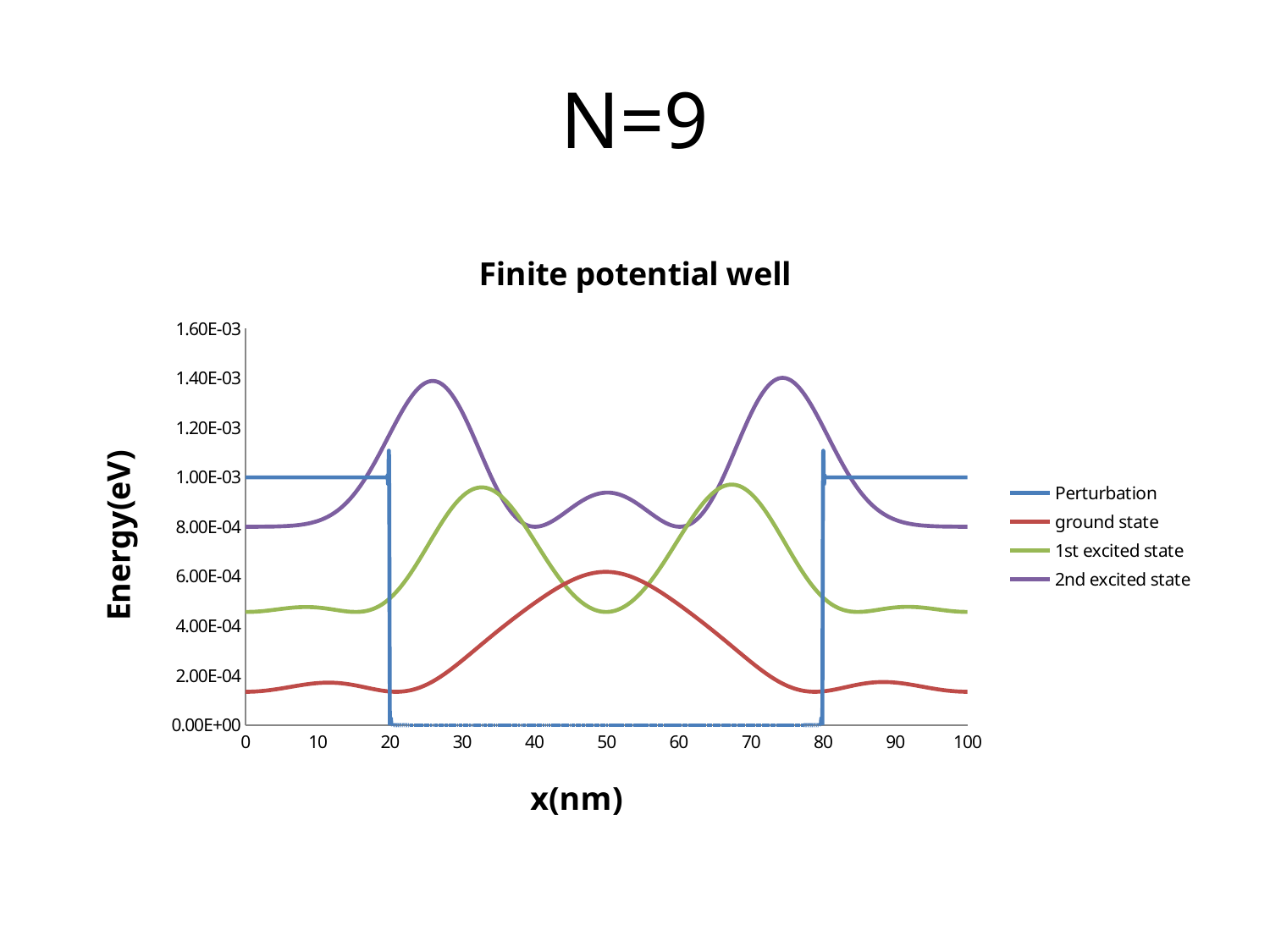
Is the peak value of the 2nd excited state near x = 25 greater or less than 1.20E-03? greater What kind of chart is shown on the slide? line chart Is the value of the 1st excited state at x = 50 greater or less than 6.00E-04? less Which series reaches the highest value anywhere on the chart? 2nd excited state Is the value of the 2nd excited state at x = 50 greater or less than 8.00E-04? greater What is the title of the chart? Finite potential well What is the label of the y axis? Energy(eV) How many series does the legend list? 4 What is the value of the Perturbation series at x = 10? 1.00E-03 What is the value of the Perturbation series at x = 50? 0.00E+00 At x = 50, which is higher: the ground state or the 1st excited state? ground state